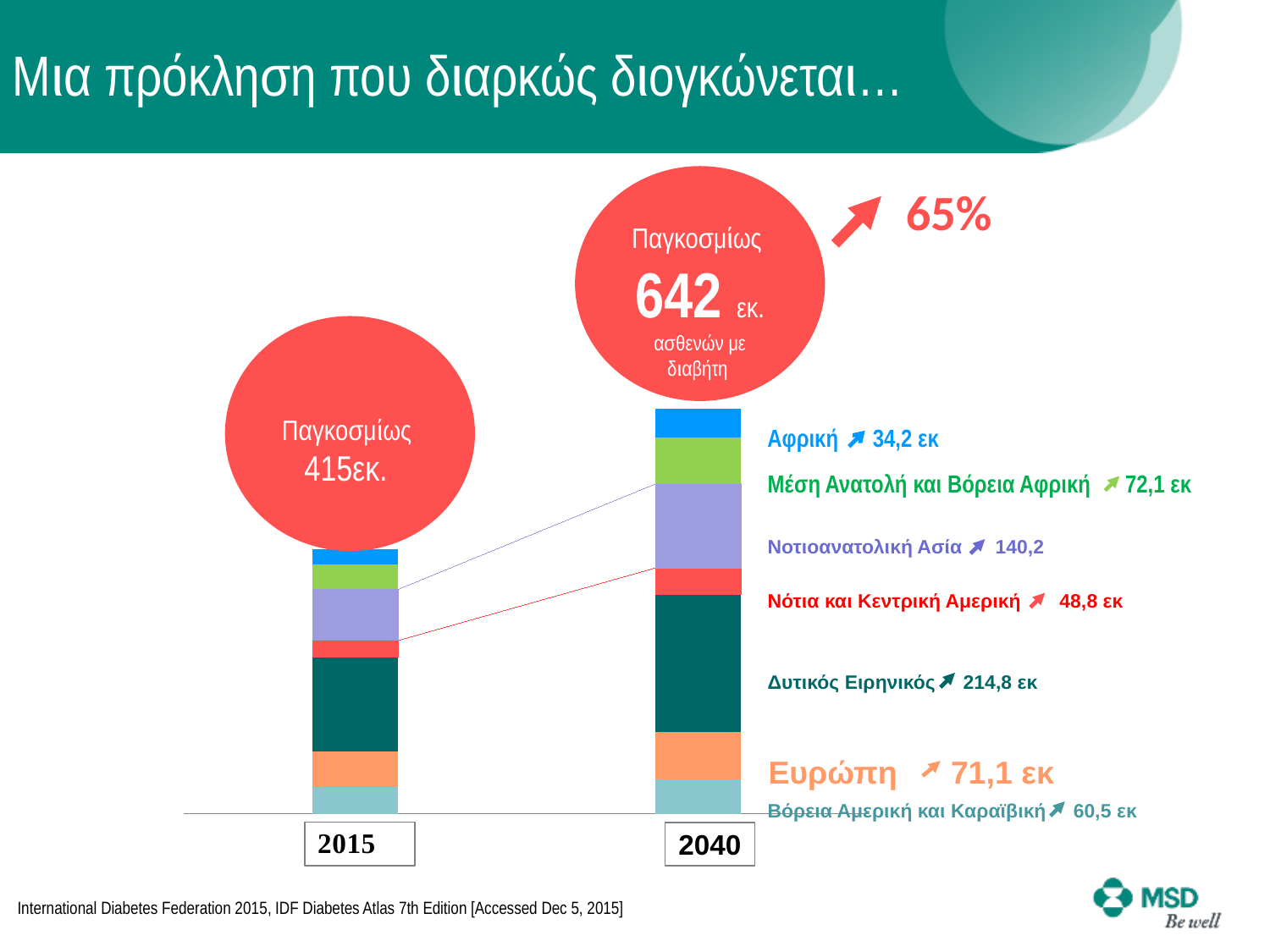
What percentage increase from 2015 to 2040 is shown on the slide? 65% How many years (bars) are shown on the x axis? 2 What is the difference between the 2040 values for Δυτικός Ειρηνικός and Νοτιοανατολική Ασία? 74,6 εκ Which region has the smallest value in 2040? Αφρική What value is shown for Δυτικός Ειρηνικός in 2040? 214,8 εκ What value is shown for Αφρική in 2040? 34,2 εκ What is the total number of people with diabetes worldwide shown for 2015? 415εκ. What value is shown for Ευρώπη in 2040? 71,1 εκ Which is larger in 2040: Μέση Ανατολή και Βόρεια Αφρική or Βόρεια Αμερική και Καραϊβική? Μέση Ανατολή και Βόρεια Αφρική What value is shown for Νοτιοανατολική Ασία in 2040? 140,2 Which region has the largest value in 2040? Δυτικός Ειρηνικός What is the total number of people with diabetes worldwide shown for 2040? 642 εκ.